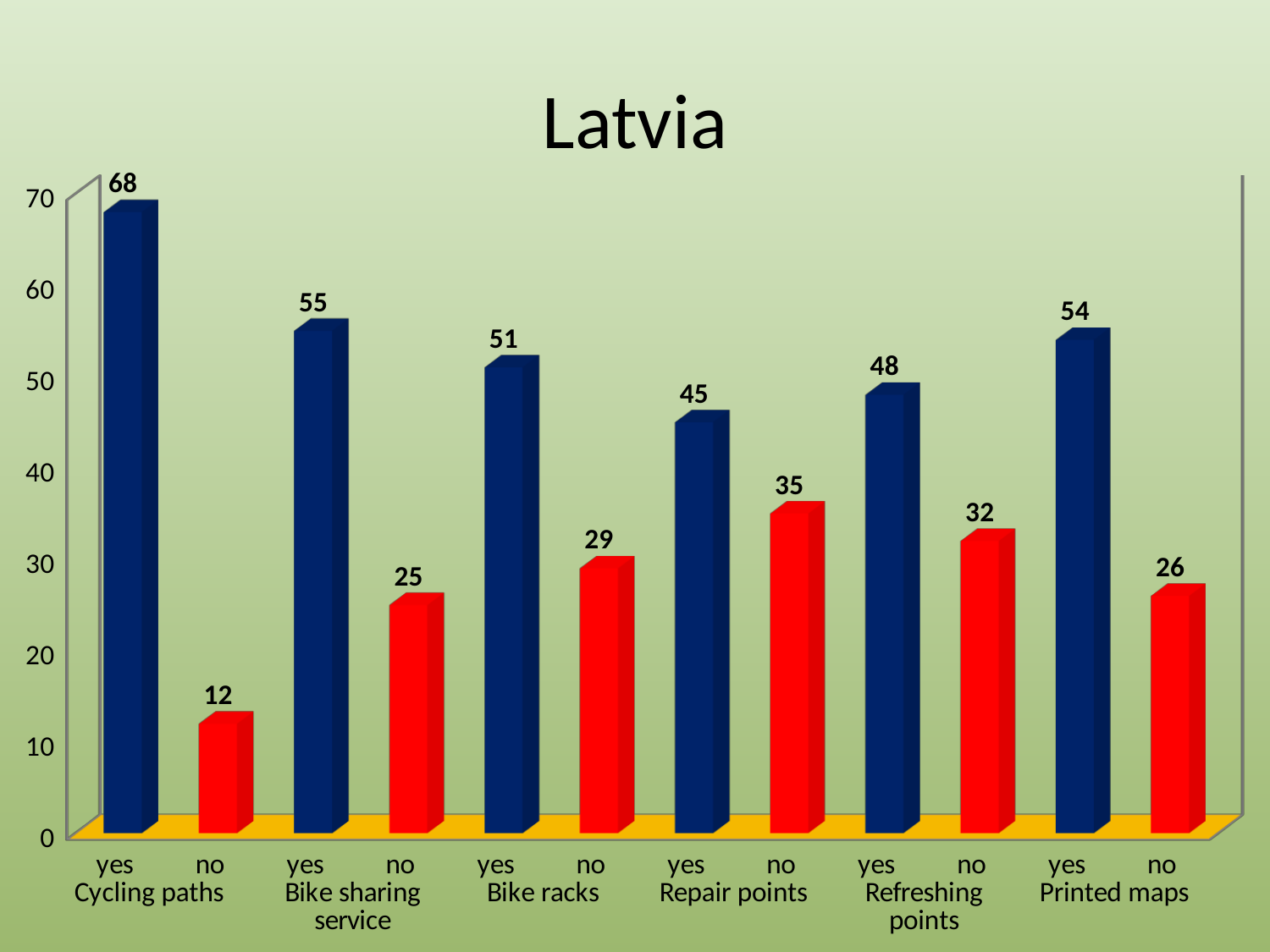
How many bars are plotted on the chart? 12 What is the value for 'yes' under Cycling paths? 68 Is the 'yes' value for Repair points greater or less than 40? greater What kind of chart is shown on the slide? bar chart What is the value for 'no' under Repair points? 35 Which bar has the lowest value on the chart? no, Cycling paths (12) Which is larger: the 'no' value for Refreshing points or the 'no' value for Bike racks? no, Refreshing points (32) What colour are the 'no' bars? red What is the difference between the 'yes' and 'no' values for Bike sharing service? 30 What is the title of the chart? Latvia Which bar has the highest value on the chart? yes, Cycling paths (68) What is the value for 'yes' under Printed maps? 54